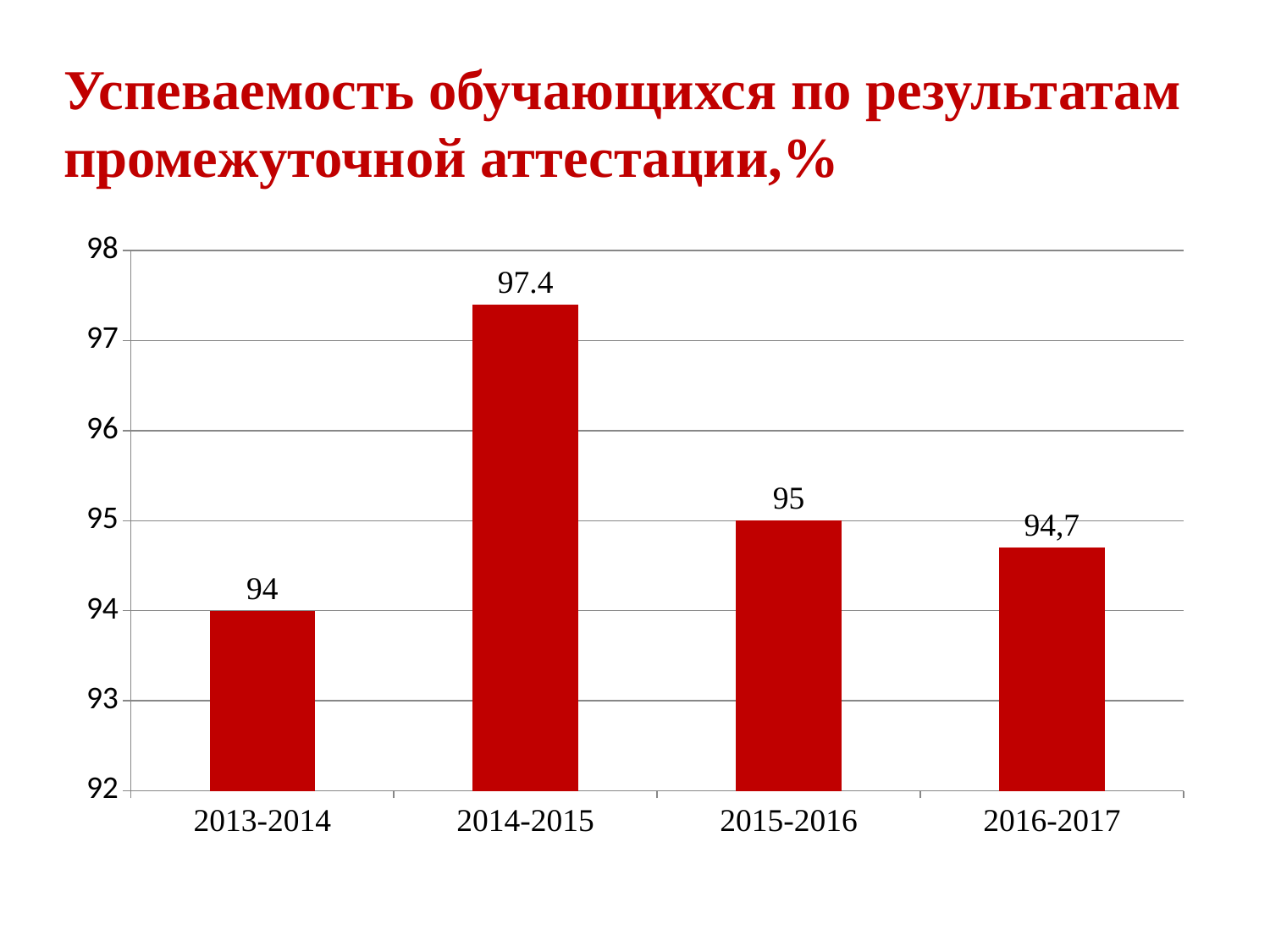
What is the value for 2014-2015? 97.4 How many years are shown on the chart? 4 Which year has the lowest value? 2013-2014 What is the difference between the values for 2014-2015 and 2013-2014? 3.4 What is the value for 2013-2014? 94 Which year has the highest value? 2014-2015 What is the value for 2015-2016? 95 Is the value for 2014-2015 greater or less than 97? greater What is the title of the chart? Успеваемость обучающихся по результатам промежуточной аттестации,% What is the value for 2016-2017? 94,7 Which is larger, the value for 2015-2016 or the value for 2016-2017? 2015-2016 What kind of chart is shown on the slide? bar chart